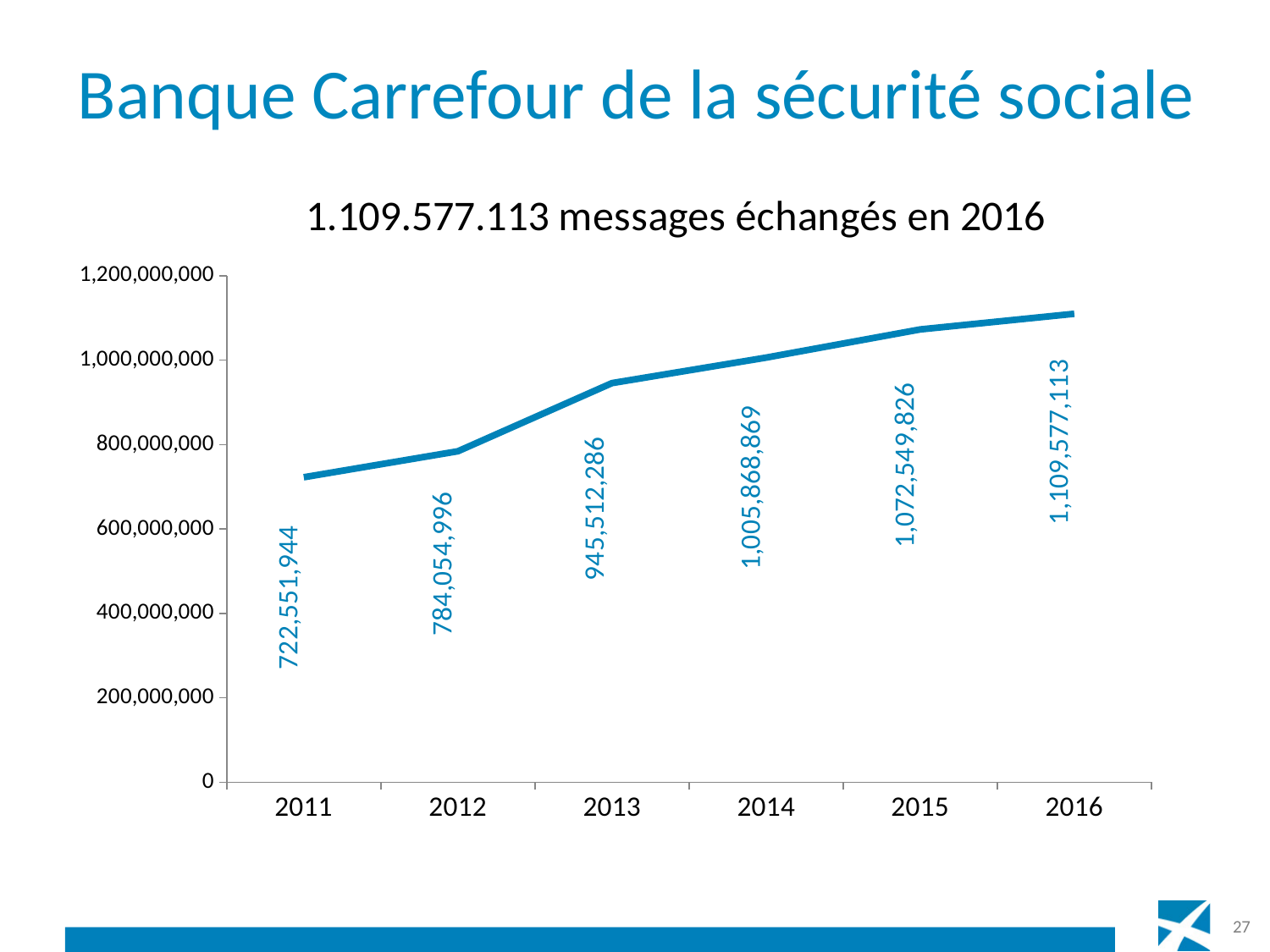
Do the values rise or fall from 2011 to 2016? rise What is the value for 2013? 945,512,286 Which year has the highest value? 2016 Is the value for 2011 greater or less than 800,000,000? less How many years are plotted on the chart? 6 Which year has the lowest value? 2011 What is the difference between the values for 2013 and 2012? 161,457,290 What is the value for 2011? 722,551,944 Which is larger, the value for 2014 or the value for 2012? 2014 What is the difference between the values for 2016 and 2011? 387,025,169 What is the value for 2016? 1,109,577,113 What kind of chart is shown on the slide? line chart